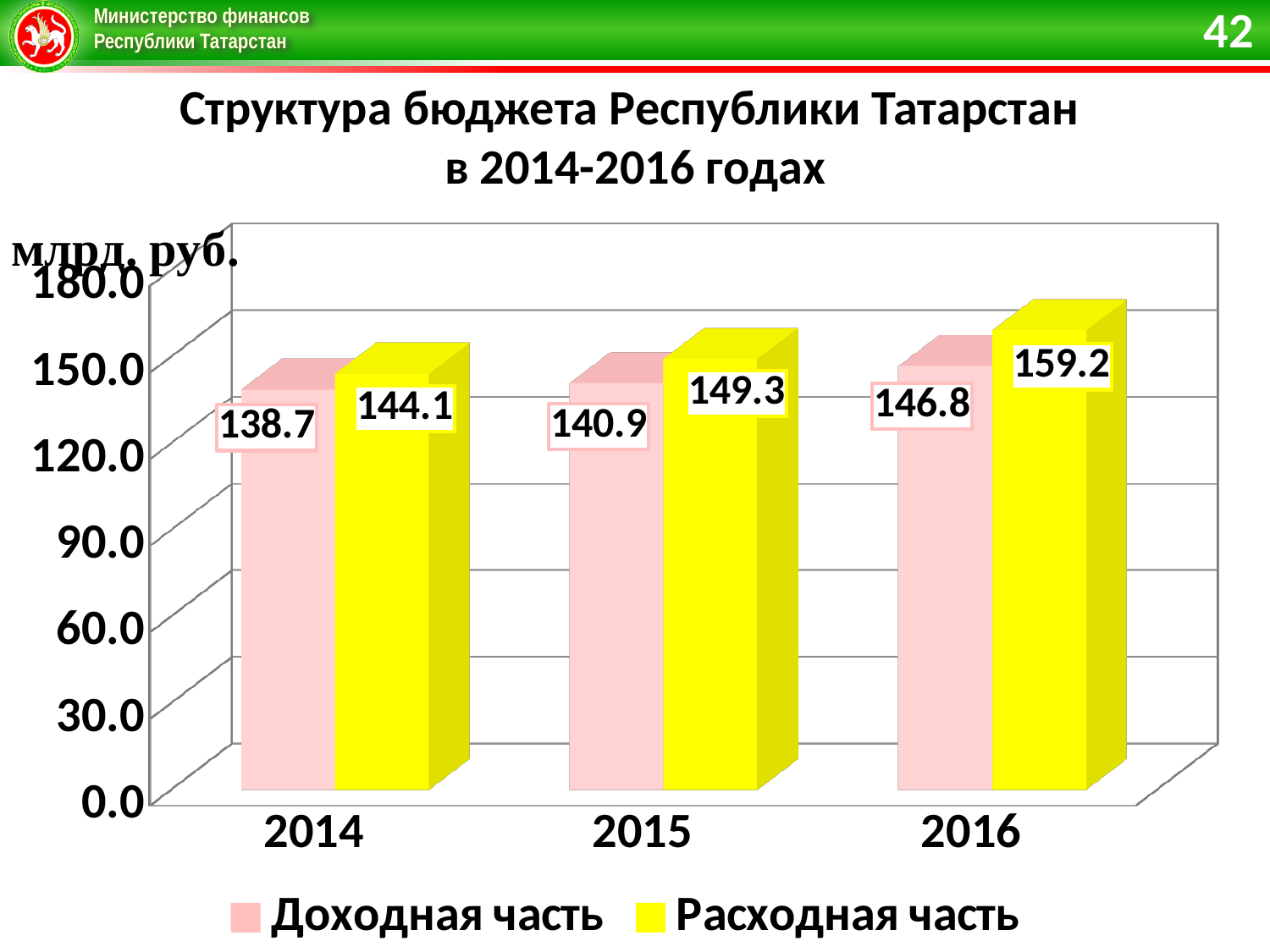
In which year is Расходная часть highest? 2016 Which is larger in 2015: Доходная часть or Расходная часть? Расходная часть Does Доходная часть rise or fall from 2014 to 2016? Rise How many years are shown on the x axis? 3 What is the value of Расходная часть for 2016? 159.2 What is the value of Доходная часть for 2014? 138.7 What is the difference between Расходная часть and Доходная часть in 2016? 12.4 In which year is Доходная часть lowest? 2014 What is the difference between Доходная часть in 2016 and in 2014? 8.1 What is the value of Расходная часть for 2015? 149.3 What kind of chart is shown on the slide? Bar chart How many series does the legend list? 2